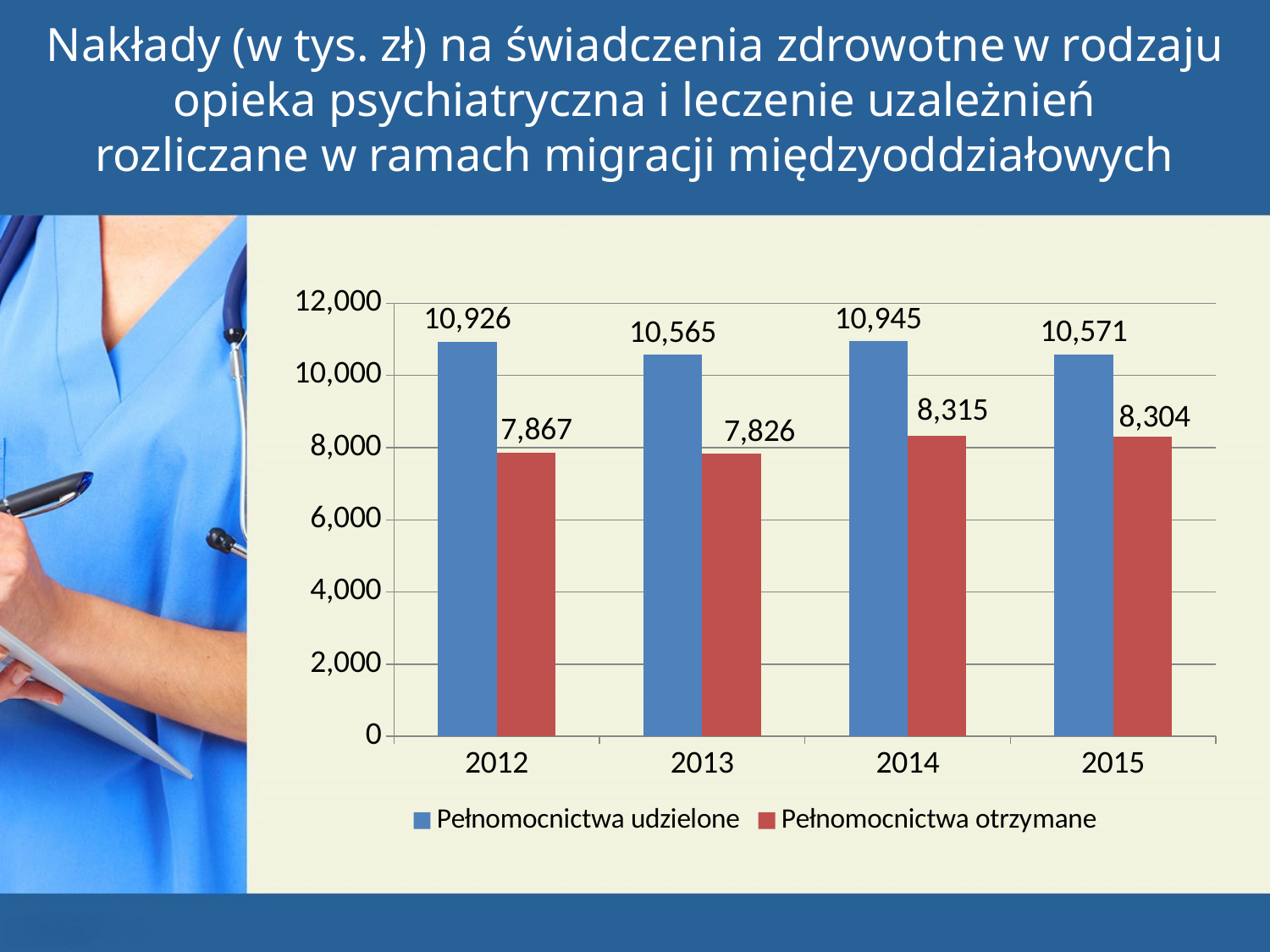
What kind of chart is shown on the slide? bar chart What is the difference between Pełnomocnictwa udzielone in 2014 and in 2013? 380 In which year is Pełnomocnictwa udzielone highest? 2014 What is the value for Pełnomocnictwa udzielone in 2012? 10,926 Which is larger: Pełnomocnictwa udzielone in 2013 or Pełnomocnictwa udzielone in 2015? Pełnomocnictwa udzielone in 2015 How many years are shown on the x axis? 4 What is the value for Pełnomocnictwa otrzymane in 2015? 8,304 Is the value for Pełnomocnictwa otrzymane in 2013 greater or less than 8,000? less What is the value for Pełnomocnictwa otrzymane in 2014? 8,315 How many series does the legend list? 2 What is the difference between Pełnomocnictwa udzielone and Pełnomocnictwa otrzymane in 2012? 3,059 In which year is Pełnomocnictwa otrzymane lowest? 2013